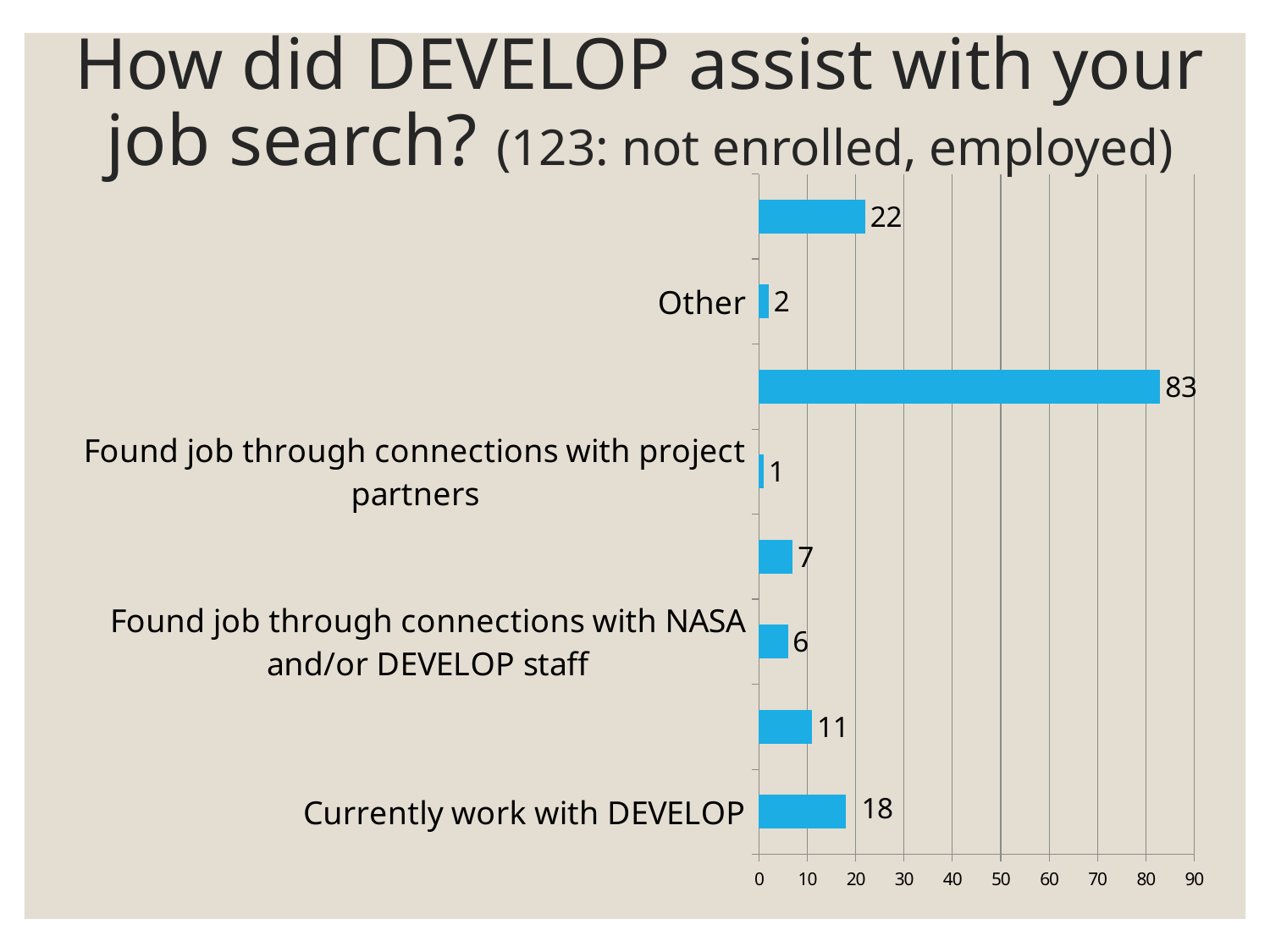
Which is larger: the value for "Other" or the value for "Found job through connections with project partners"? Other Which category has the lowest value? Found job through connections with project partners What is the value for "Other"? 2 How many bars are plotted on the chart? 8 What is the difference between the values for "Currently work with DEVELOP" and "Found job through connections with NASA and/or DEVELOP staff"? 12 What kind of chart is shown on the slide? bar chart What is the title of the slide? How did DEVELOP assist with your job search? (123: not enrolled, employed) What is the value for "Found job through connections with NASA and/or DEVELOP staff"? 6 Is the value for "Currently work with DEVELOP" greater or less than 10? greater What is the value for "Currently work with DEVELOP"? 18 What is the largest value shown on the chart? 83 What is the value for "Found job through connections with project partners"? 1